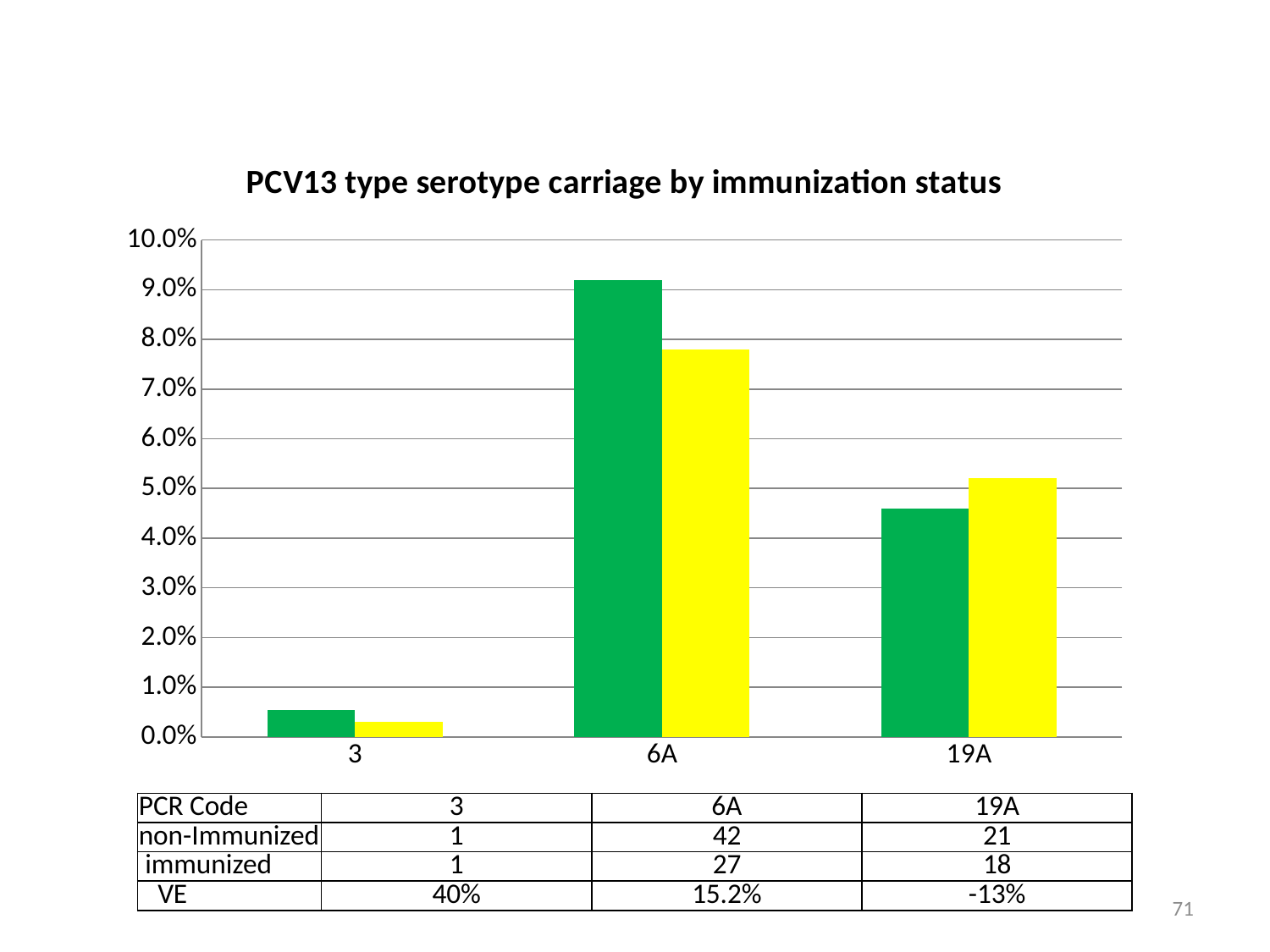
For serotype 19A, which bar is taller, the green bar or the yellow bar? the yellow bar Which serotype category has the tallest bars in the chart? 6A Is the value of the green bar for 6A greater or less than 8.0%? greater What kind of chart is shown on the slide? bar chart How many serotype categories are shown on the x axis of the chart? 3 Which serotype category has the shortest bars in the chart? 3 Is the value of the yellow bar for 6A greater or less than 8.0%? less Is the value of the green bar for 19A greater or less than 4.0%? greater What is the highest value shown on the y axis of the chart? 10.0% For serotype 6A, which bar is taller, the green bar or the yellow bar? the green bar What is the title of the chart? PCV13 type serotype carriage by immunization status